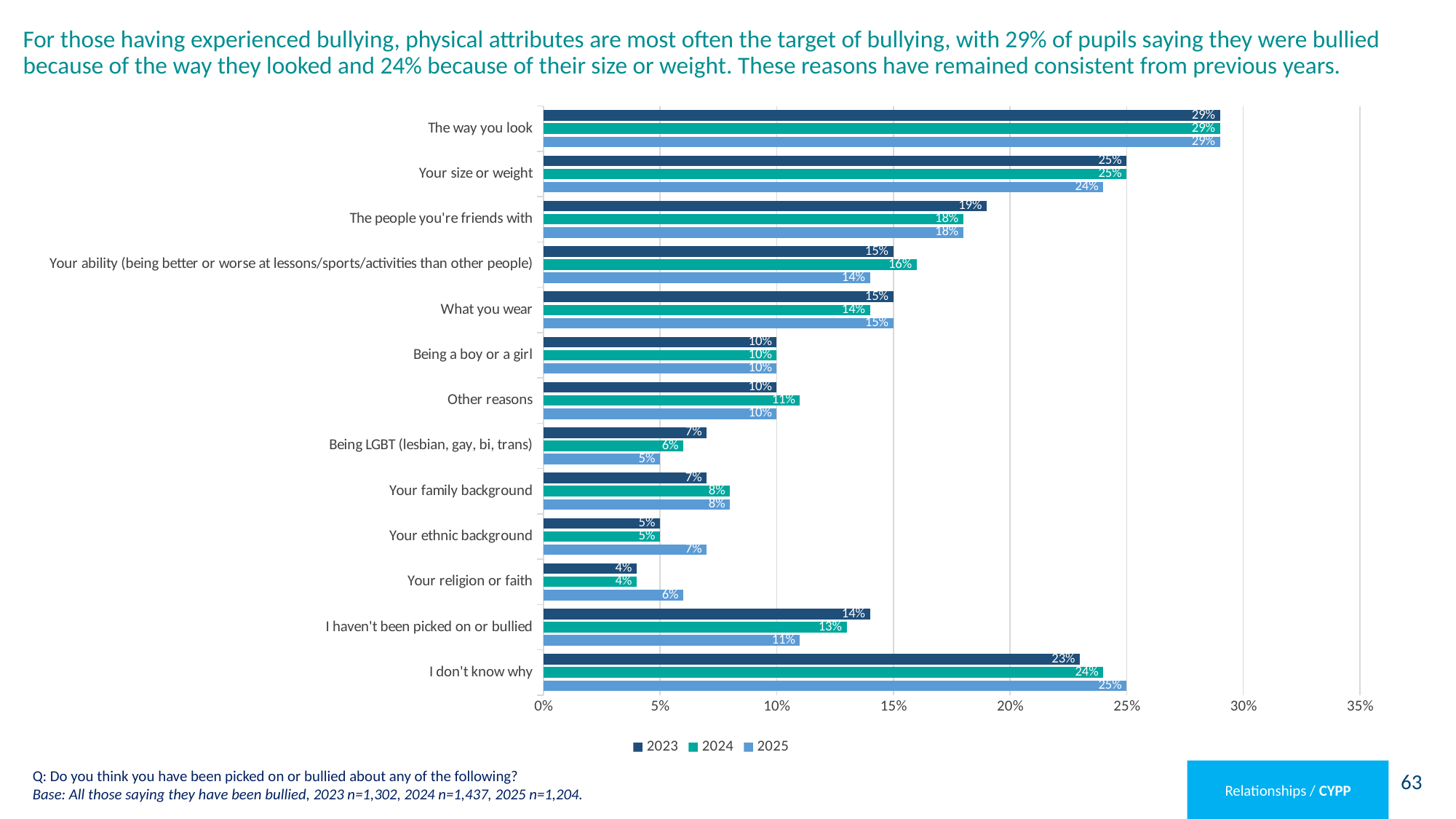
What kind of chart is shown on the slide? Bar chart Which category has the lowest 2023 value? Your religion or faith What is the 2024 value for 'I haven't been picked on or bullied'? 13% Which category has the highest 2025 value? The way you look How many categories are shown on the chart? 13 What is the difference between the 2023 and 2025 values for 'I haven't been picked on or bullied'? 3% Which series is shown in the darkest blue colour? 2023 What is the 2025 value for 'Your size or weight'? 24% Is the 2025 value for 'I don't know why' greater or less than 20%? greater How many series does the legend list? 3 Which is larger for 'Your ethnic background': the 2023 value or the 2025 value? 2025 What is the 2023 value for 'The people you're friends with'? 19%